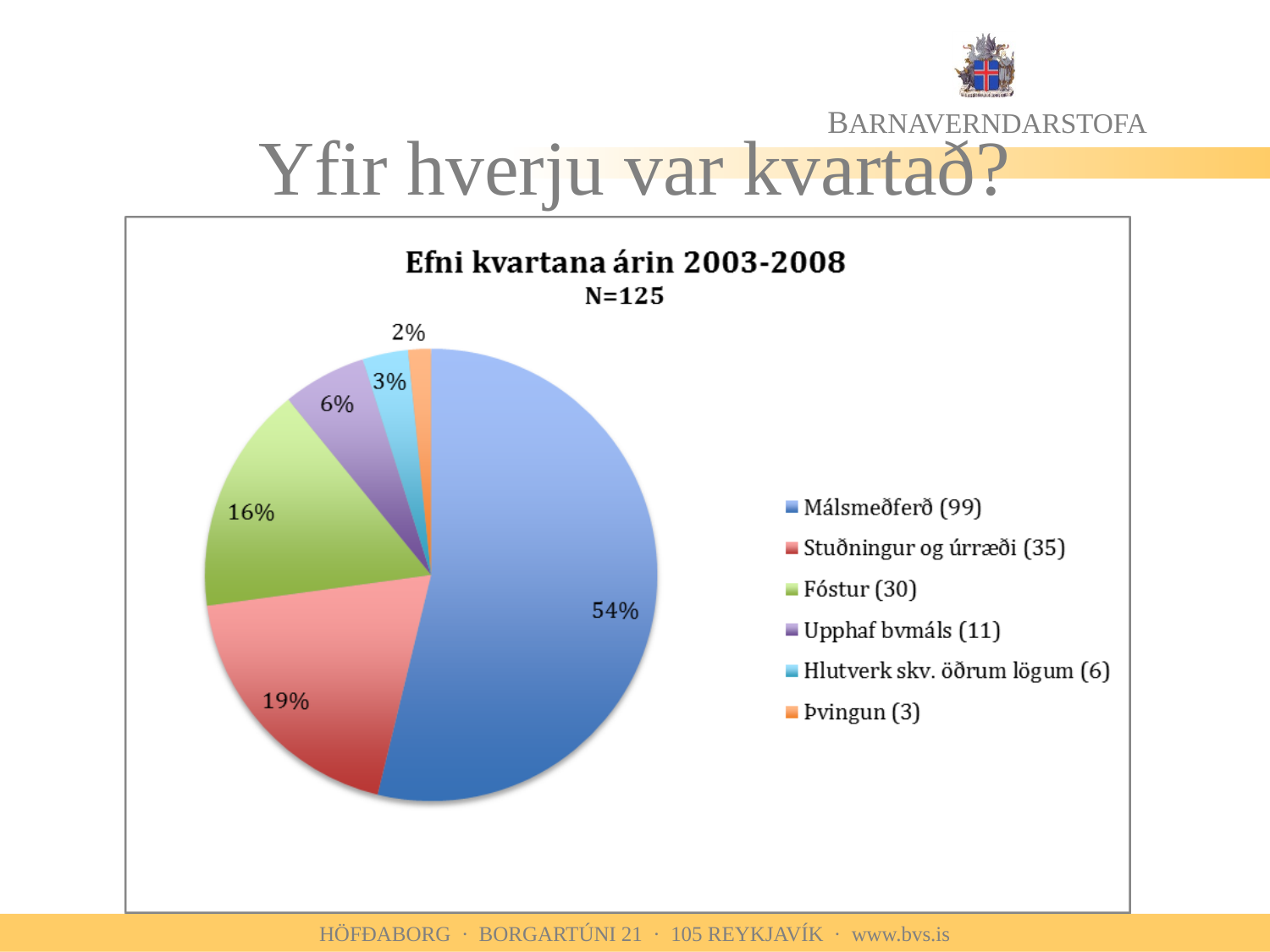
What share of the pie does Stuðningur og úrræði take? 19% What share of the pie does Málsmeðferð take? 54% What kind of chart is shown on the slide? pie chart What share of the pie does Þvingun take? 2% Which is larger, the share for Fóstur or the share for Upphaf bvmáls? Fóstur What is the difference in percentage points between the Málsmeðferð slice and the Stuðningur og úrræði slice? 35 percentage points Which category has the smallest slice of the pie? Þvingun Which category has the largest slice of the pie? Málsmeðferð How many slices does the pie chart have? 6 What is the title of the chart? Efni kvartana árin 2003-2008